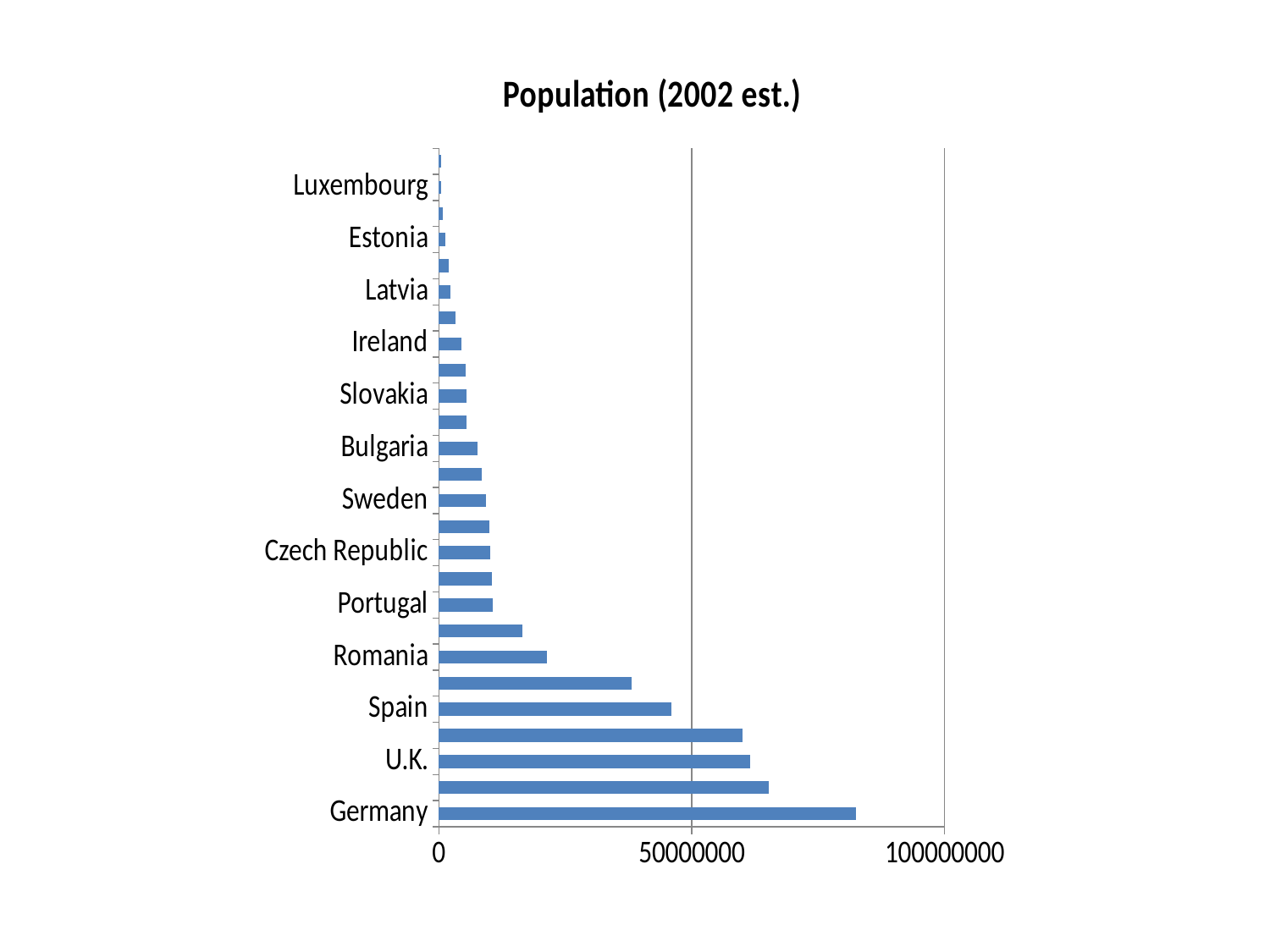
Which has the larger population, Germany or U.K.? Germany Which country has the highest population in the chart? Germany What is the title of the chart? Population (2002 est.) Do the bar lengths increase or decrease going from the top of the chart (Luxembourg) to the bottom (Germany)? increase Is the value for Germany greater or less than 100000000? less Is the value for Spain greater or less than 50000000? less Which has the larger population, Romania or Portugal? Romania What type of chart is shown on the slide? bar chart Which has the larger population, Spain or Romania? Spain Is the value for Romania greater or less than 50000000? less